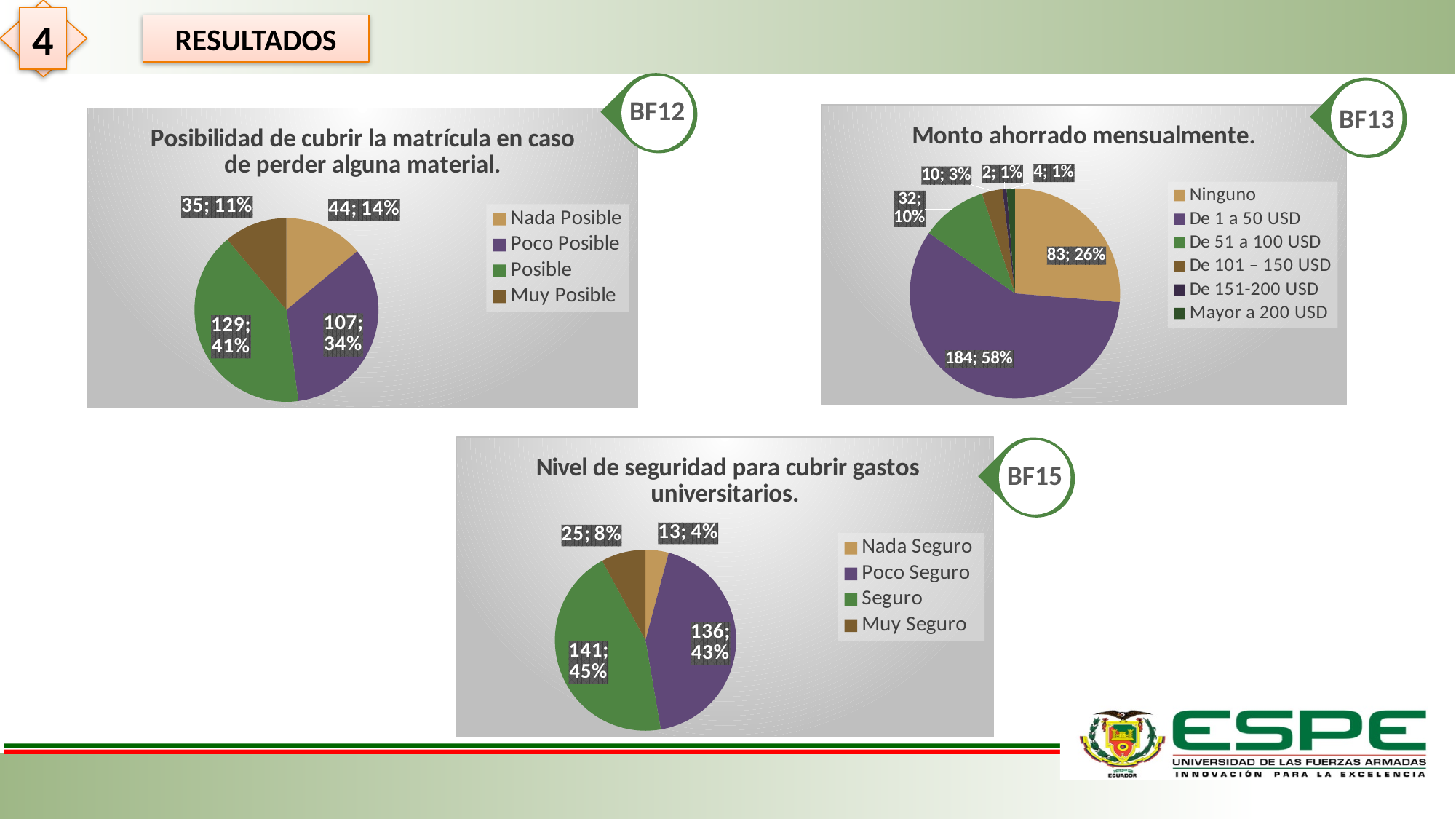
What kind of chart is the one titled "Nivel de seguridad para cubrir gastos universitarios."? Pie chart In the chart titled "Monto ahorrado mensualmente.", which category has the largest slice? De 1 a 50 USD In the chart titled "Monto ahorrado mensualmente.", what percentage share does Ninguno have? 26% In the chart titled "Posibilidad de cubrir la matrícula en caso de perder alguna material.", which category has the smallest slice? Muy Posible In the chart titled "Monto ahorrado mensualmente.", how many categories does the legend list? 6 In the chart titled "Monto ahorrado mensualmente.", which is larger, the count for De 51 a 100 USD or the count for De 101 – 150 USD? De 51 a 100 USD In the chart titled "Monto ahorrado mensualmente.", what count is shown for De 1 a 50 USD? 184 In the chart titled "Posibilidad de cubrir la matrícula en caso de perder alguna material.", what is the difference between the counts for Posible and Poco Posible? 22 In the chart titled "Nivel de seguridad para cubrir gastos universitarios.", what count is shown for Seguro? 141 In the chart titled "Posibilidad de cubrir la matrícula en caso de perder alguna material.", what count is shown for Posible? 129 In the chart titled "Nivel de seguridad para cubrir gastos universitarios.", what percentage share does Nada Seguro have? 4% In the chart titled "Posibilidad de cubrir la matrícula en caso de perder alguna material.", what percentage share does Poco Posible have? 34%